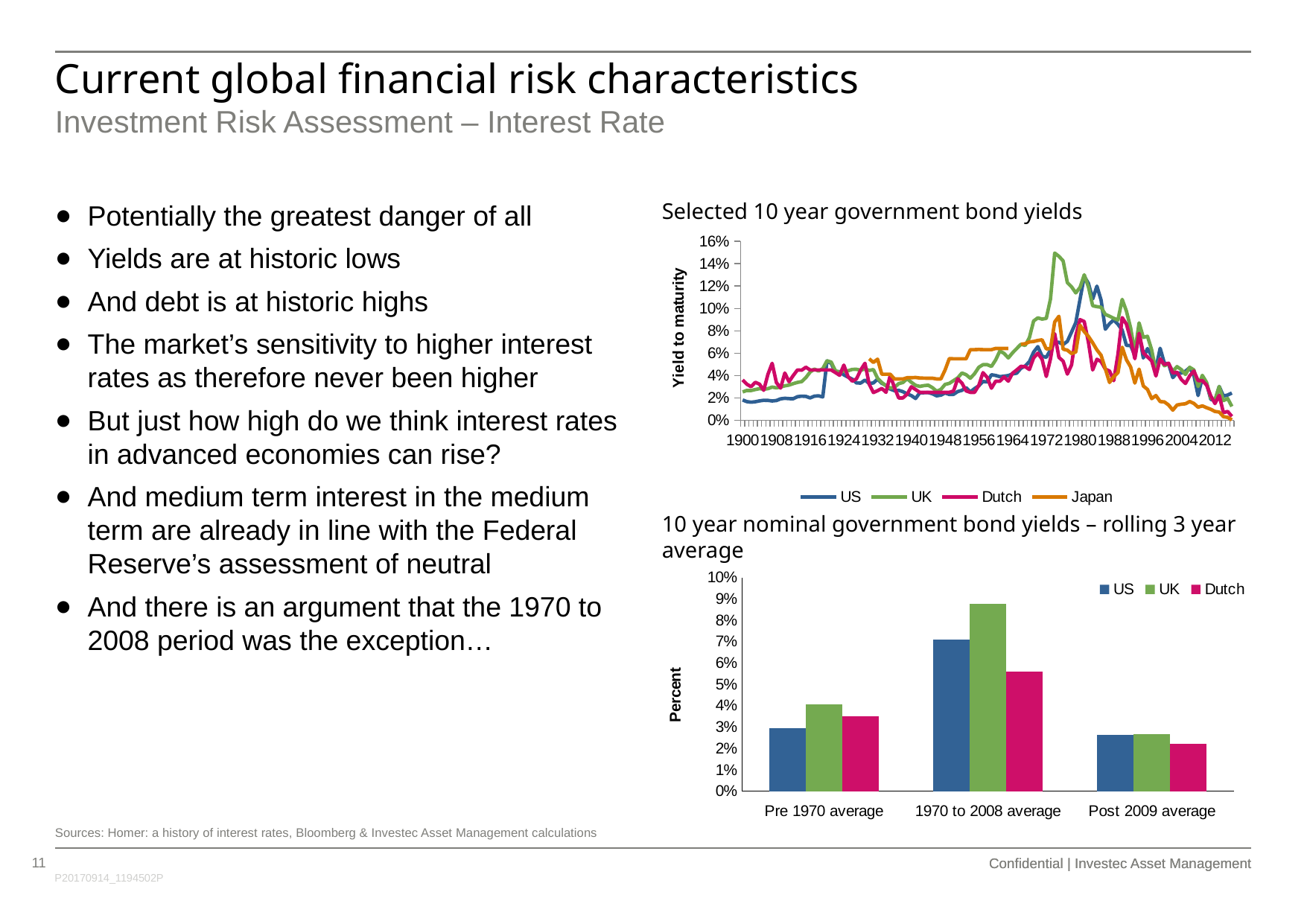
In the bottom chart, '10 year nominal government bond yields – rolling 3 year average', which series is lowest for the 1970 to 2008 average? Dutch In the bottom chart, '10 year nominal government bond yields – rolling 3 year average', is the US value for the Pre 1970 average greater or less than 4%? less What kind of chart is the bottom chart, '10 year nominal government bond yields – rolling 3 year average'? Bar chart In the bottom chart, '10 year nominal government bond yields – rolling 3 year average', which is larger for the Pre 1970 average: US or UK? UK In the top chart, 'Selected 10 year government bond yields', which series reaches the highest peak? UK How many categories are shown on the x axis of the bottom chart, '10 year nominal government bond yields – rolling 3 year average'? 3 How many series does the legend of the bottom chart, '10 year nominal government bond yields – rolling 3 year average', list? 3 In the bottom chart, '10 year nominal government bond yields – rolling 3 year average', which series is highest for the 1970 to 2008 average? UK What kind of chart is the top chart, 'Selected 10 year government bond yields'? Line chart In the top chart, 'Selected 10 year government bond yields', do yields rise or fall from the early 1980s to 2012? Fall In the bottom chart, '10 year nominal government bond yields – rolling 3 year average', is the UK value for the 1970 to 2008 average greater or less than 8%? greater How many series does the legend of the top chart, 'Selected 10 year government bond yields', list? 4